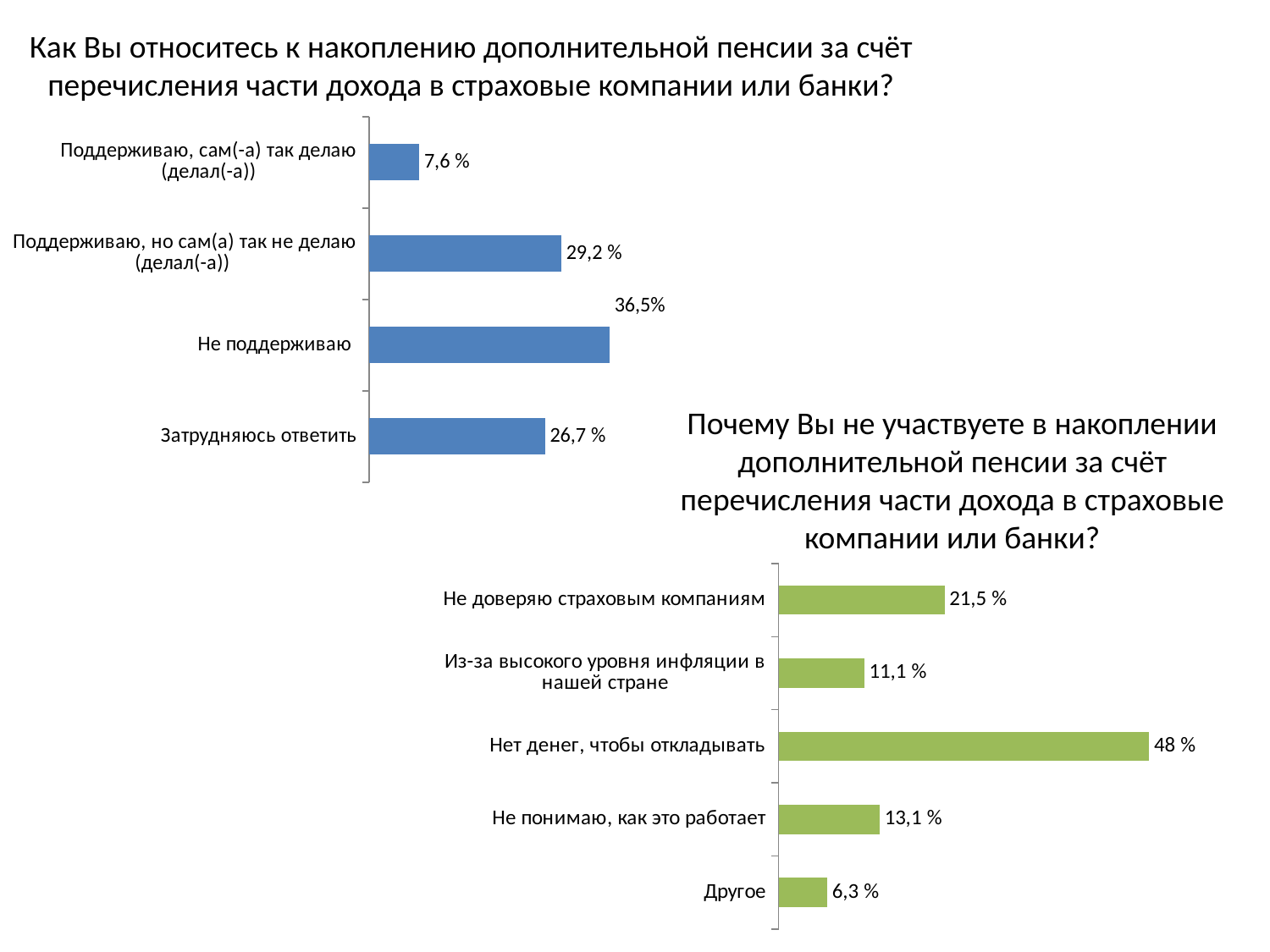
In the bottom-right chart ("Почему Вы не участвуете в накоплении..."), what is the value for "Нет денег, чтобы откладывать"? 48 % In the top-left chart ("Как Вы относитесь к накоплению дополнительной пенсии..."), what is the value for "Не поддерживаю"? 36,5% In the bottom-right chart, which category has the lowest value? Другое What type of chart is the bottom-right chart? Bar chart In the top-left chart, what is the difference between "Поддерживаю, но сам(а) так не делаю (делал(-а))" and "Затрудняюсь ответить"? 2,5 % In the bottom-right chart, what is the value for "Из-за высокого уровня инфляции в нашей стране"? 11,1 % How many categories does the bottom-right chart show? 5 In the top-left chart, which category has the lowest value? Поддерживаю, сам(-а) так делаю (делал(-а)) In the top-left chart, what is the value for "Поддерживаю, сам(-а) так делаю (делал(-а))"? 7,6 % In the top-left chart, which category has the highest value? Не поддерживаю In the bottom-right chart, which is larger: "Не доверяю страховым компаниям" or "Не понимаю, как это работает"? Не доверяю страховым компаниям How many categories does the top-left chart show? 4